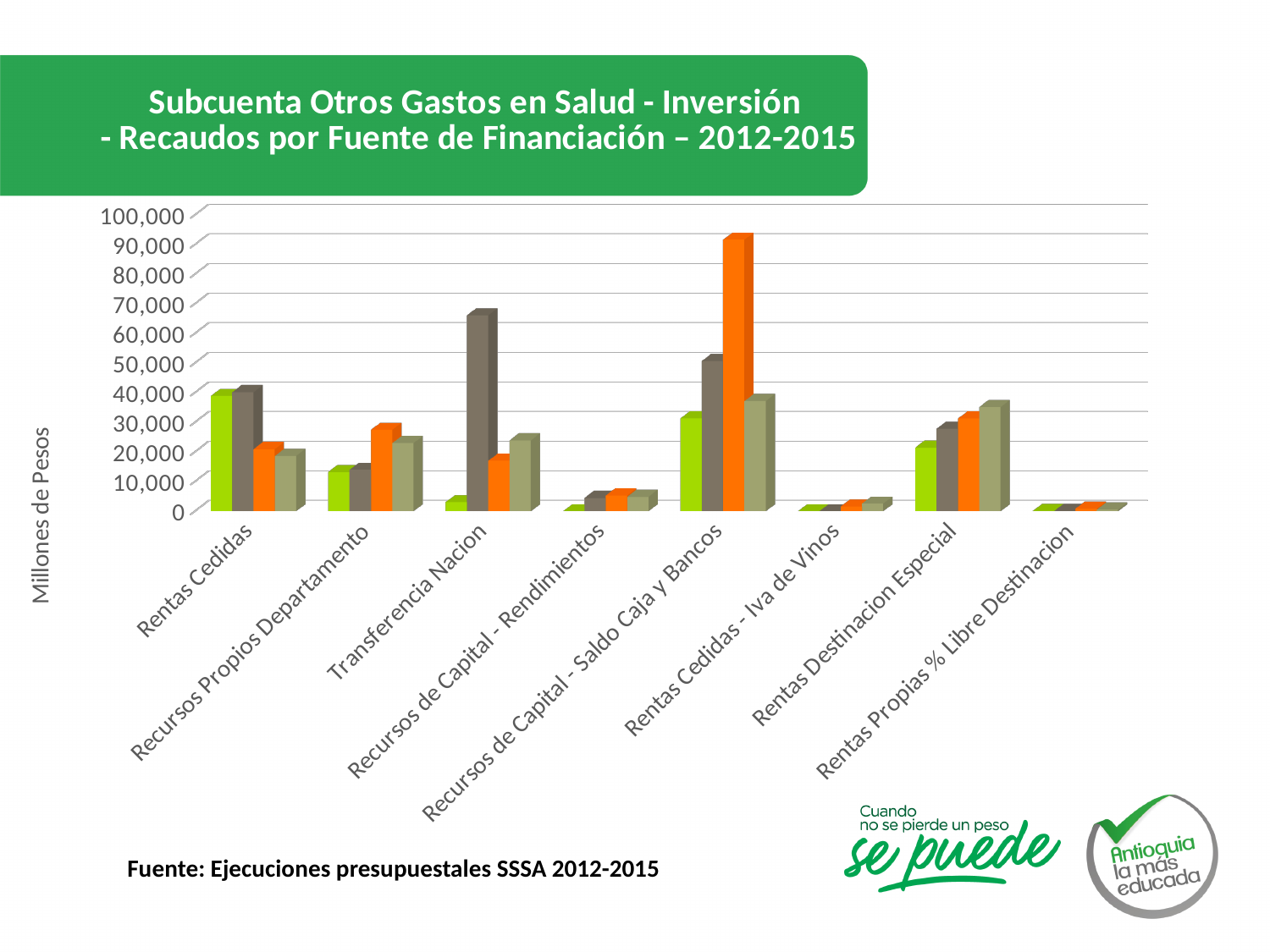
What is the highest tick value shown on the vertical axis of the chart? 100,000 How many funding-source categories are shown on the x axis of the chart? 8 What kind of chart is shown on the slide? bar chart Is the value of the orange bar for Recursos de Capital - Saldo Caja y Bancos greater or less than 80,000? greater How many bars are plotted for each category in the chart? 4 Is the value of the green bar for Rentas Cedidas greater or less than 30,000? greater Which has the larger orange bar: Rentas Cedidas or Recursos Propios Departamento? Recursos Propios Departamento Is the value of the green bar for Transferencia Nacion greater or less than 10,000? less Which category contains the tallest bar in the chart? Recursos de Capital - Saldo Caja y Bancos What is the label of the vertical axis of the chart? Millones de Pesos Which has the larger green bar: Rentas Cedidas or Recursos Propios Departamento? Rentas Cedidas